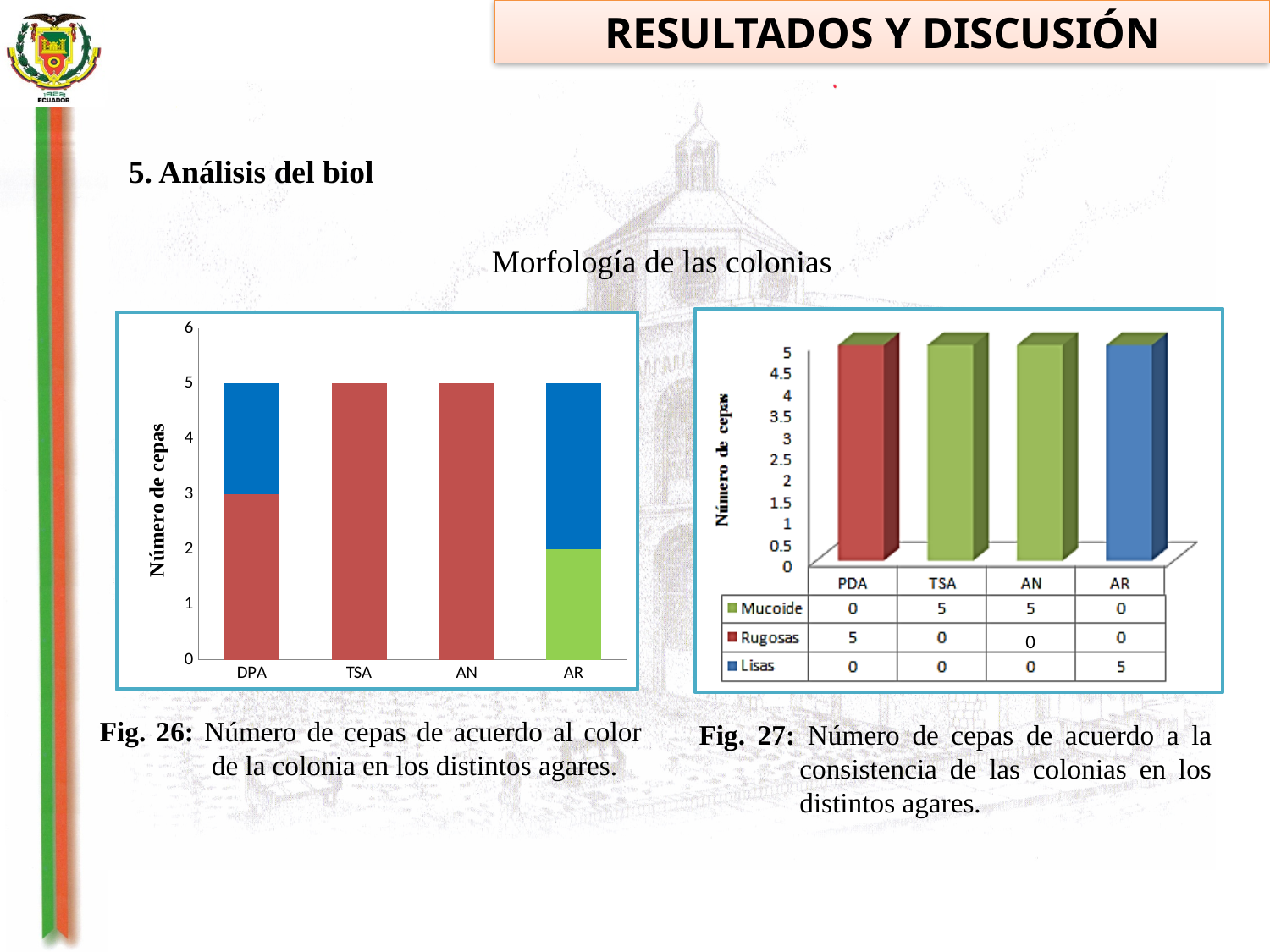
In the Fig. 27 chart (right), how many series are listed in the legend? 3 In the Fig. 27 chart (right), what is the Lisas value for AR? 5 In the Fig. 26 chart (left), how many categories are shown on the x axis? 4 In the Fig. 27 chart (right), how many agar categories are shown on the x axis? 4 In the Fig. 27 chart (right), what is the Rugosas value for PDA? 5 What kind of chart is the Fig. 26 chart (left)? Stacked bar chart In the Fig. 27 chart (right), what is the Mucoide value for AR? 0 In the Fig. 27 chart (right), what is the difference between the Mucoide and Rugosas values for TSA? 5 In the Fig. 26 chart (left), what is the title of the y axis? Número de cepas In the Fig. 27 chart (right), what is the Mucoide value for TSA? 5 In the Fig. 27 chart (right), which series has a value of 5 for AN? Mucoide In the Fig. 26 chart (left), what is the total height of the stacked bar for DPA? 5